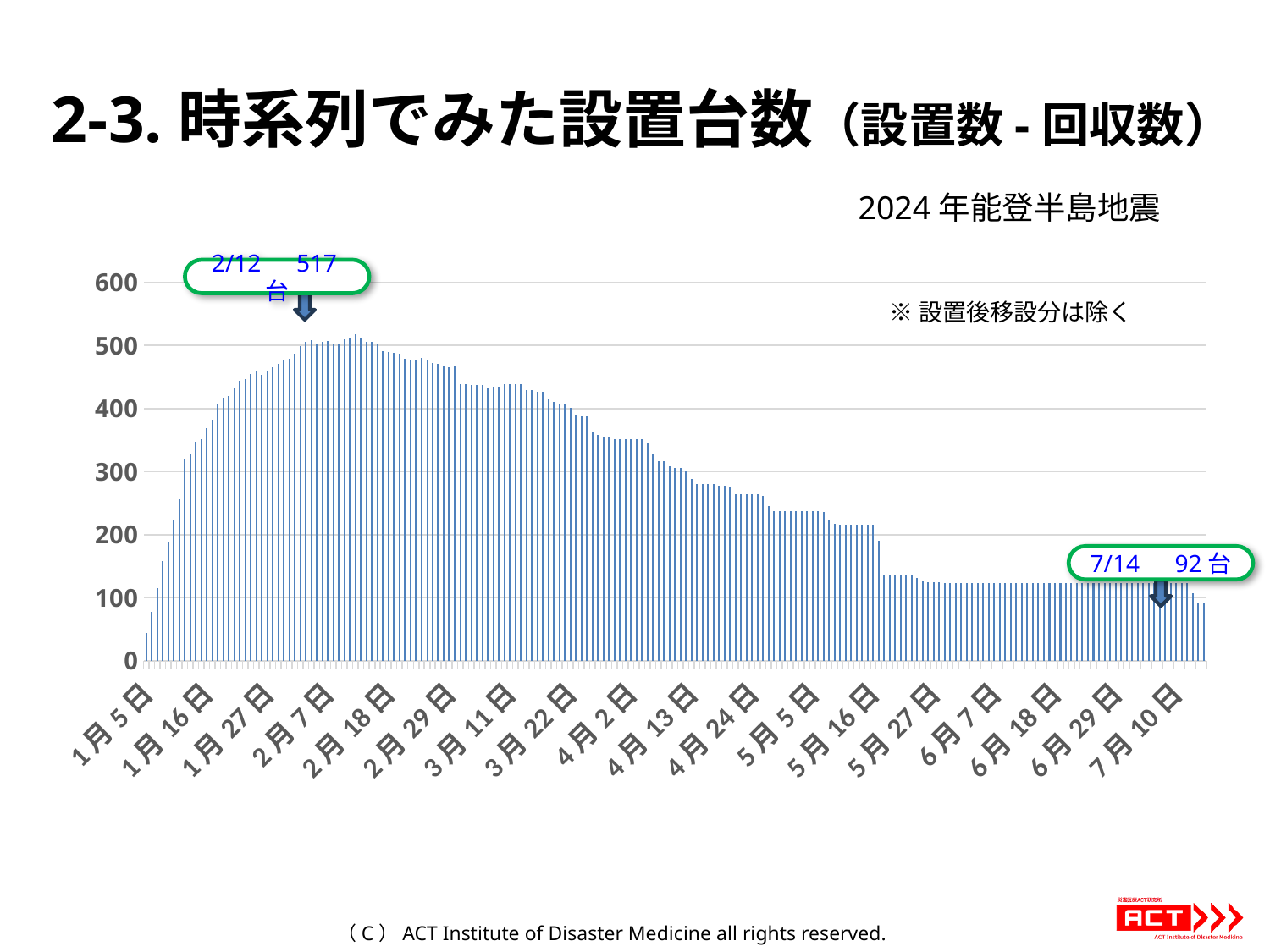
What is the difference between the annotated values for 2/12 and 7/14? 425台 What kind of chart is shown on the slide? bar chart Is the value for 4月24日 greater or less than 300? less Is the value for 6月7日 greater or less than 200? less Which is larger, the value for 3月11日 or the value for 5月16日? 3月11日 Do the values rise or fall from 2月18日 to 7月10日? fall Is the value for 1月5日 greater or less than 100? less What value is annotated for 2/12? 517台 On which date does the chart reach its highest value? 2/12 What value is annotated for 7/14? 92台 What note is shown in the upper right of the chart area? ※設置後移設分は除く